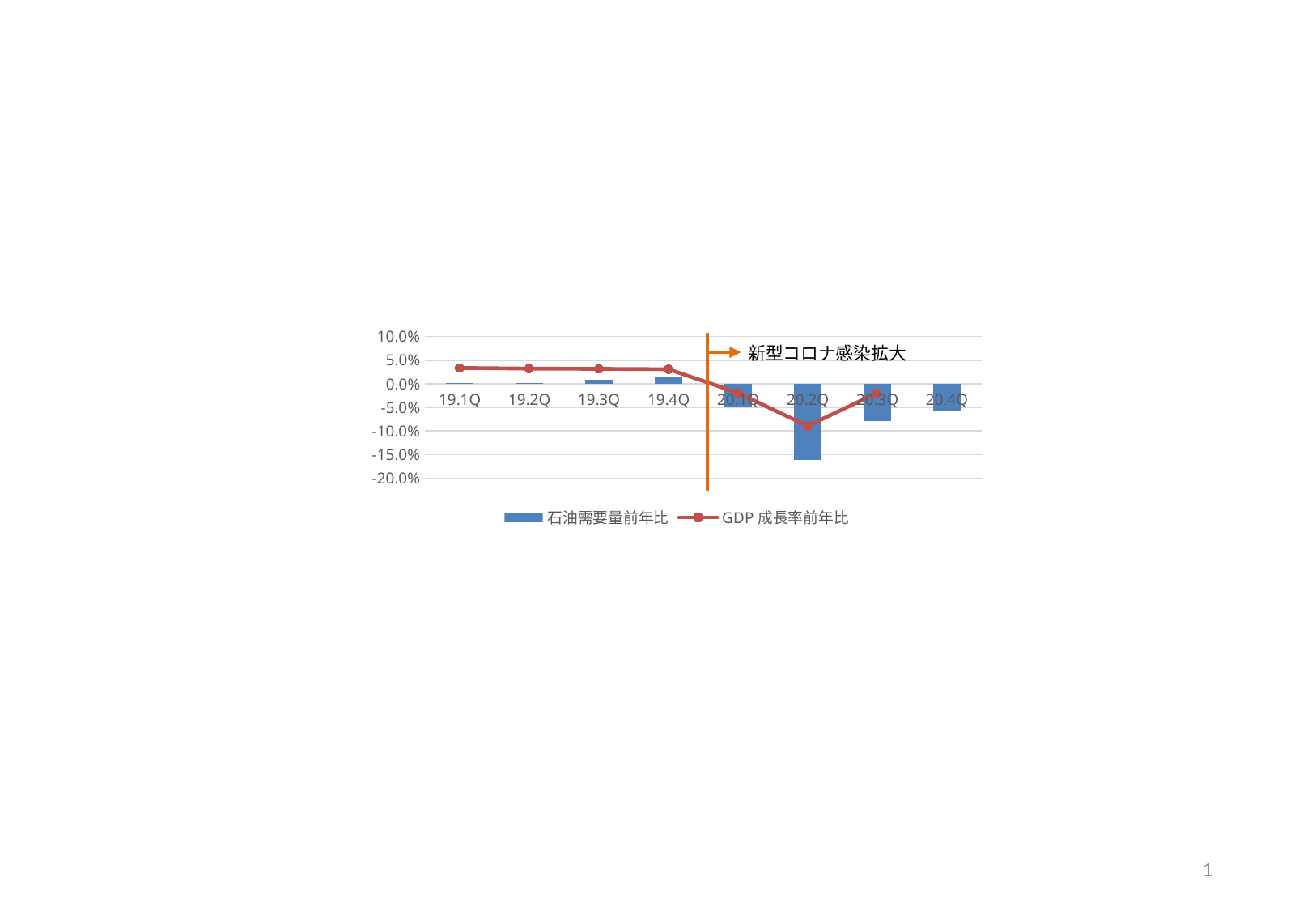
What kind of chart is shown on the slide? A combined bar and line chart Is the GDP 成長率前年比 value for 20.2Q greater or less than -5.0%? less Is the 石油需要量前年比 value for 20.2Q greater or less than -10.0%? less Which quarter has the lowest value for GDP 成長率前年比? 20.2Q Which is lower, the 石油需要量前年比 value for 20.2Q or for 20.3Q? 20.2Q How many quarters are shown on the x axis of the chart? 8 What text is written next to the orange vertical line on the chart? 新型コロナ感染拡大 Which quarter has the lowest value for 石油需要量前年比? 20.2Q Is the GDP 成長率前年比 value for 19.1Q greater or less than 0.0%? greater Which series is drawn as bars in the chart? 石油需要量前年比 Does the GDP 成長率前年比 line rise or fall from 19.4Q to 20.2Q? It falls How many series does the chart's legend list? 2